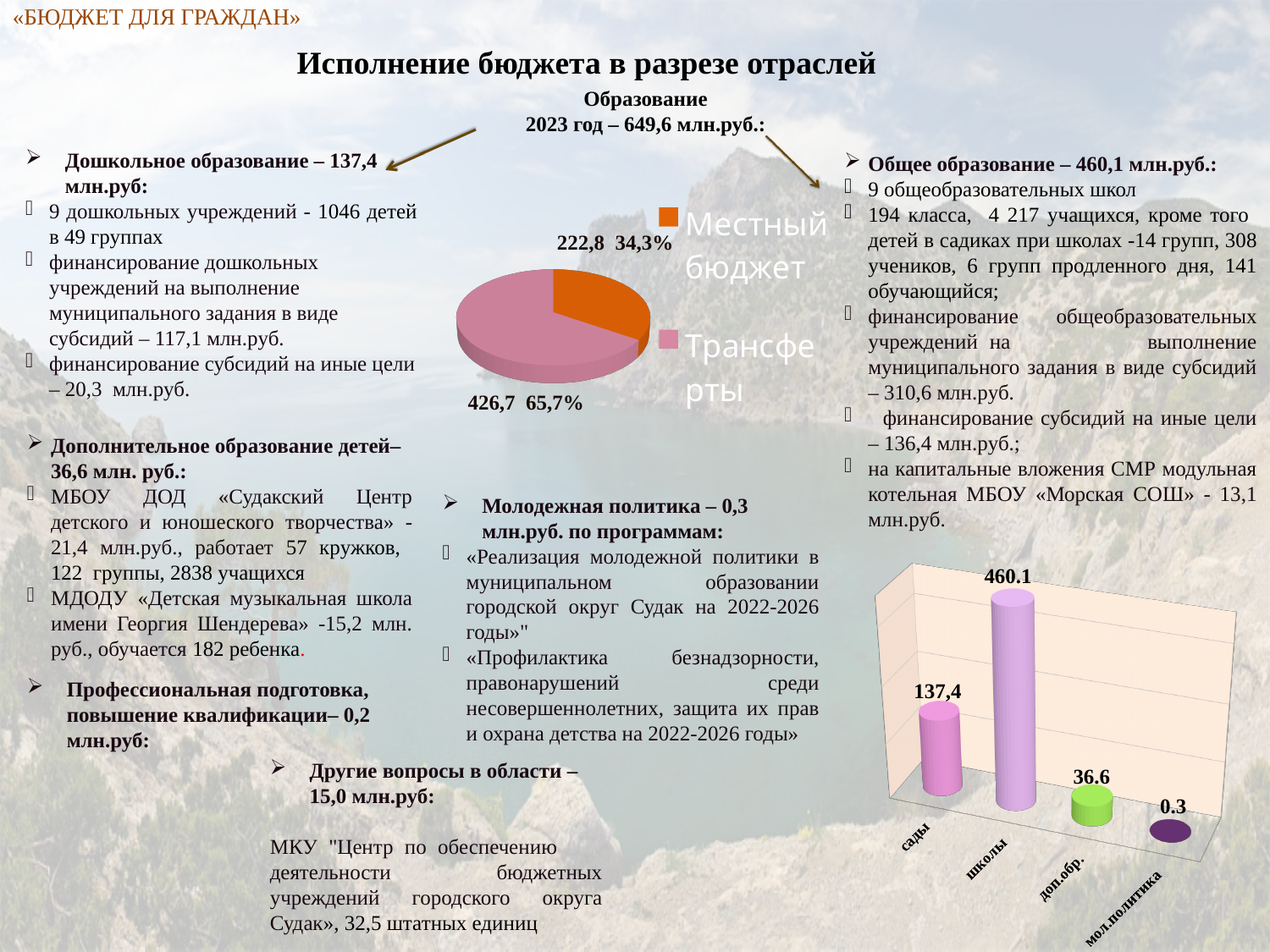
In the bar chart at the bottom right, what is the value for школы? 460.1 In the pie chart, what percentage share is shown for Местный бюджет? 34,3% How many categories are shown in the bar chart at the bottom right? 4 How many entries does the legend of the pie chart list? 2 In the bar chart at the bottom right, which category has the lowest value? мол.политика In the pie chart, which slice is larger, Местный бюджет or Трансферты? Трансферты What type of chart is shown in the bottom right of the slide? bar chart In the bar chart at the bottom right, what is the value for сады? 137,4 In the pie chart, what is the difference between the values for Трансферты and Местный бюджет? 203,9 In the bar chart at the bottom right, which category has the highest value? школы In the pie chart, what percentage share is shown for Трансферты? 65,7% In the pie chart, what value is shown for Местный бюджет? 222,8